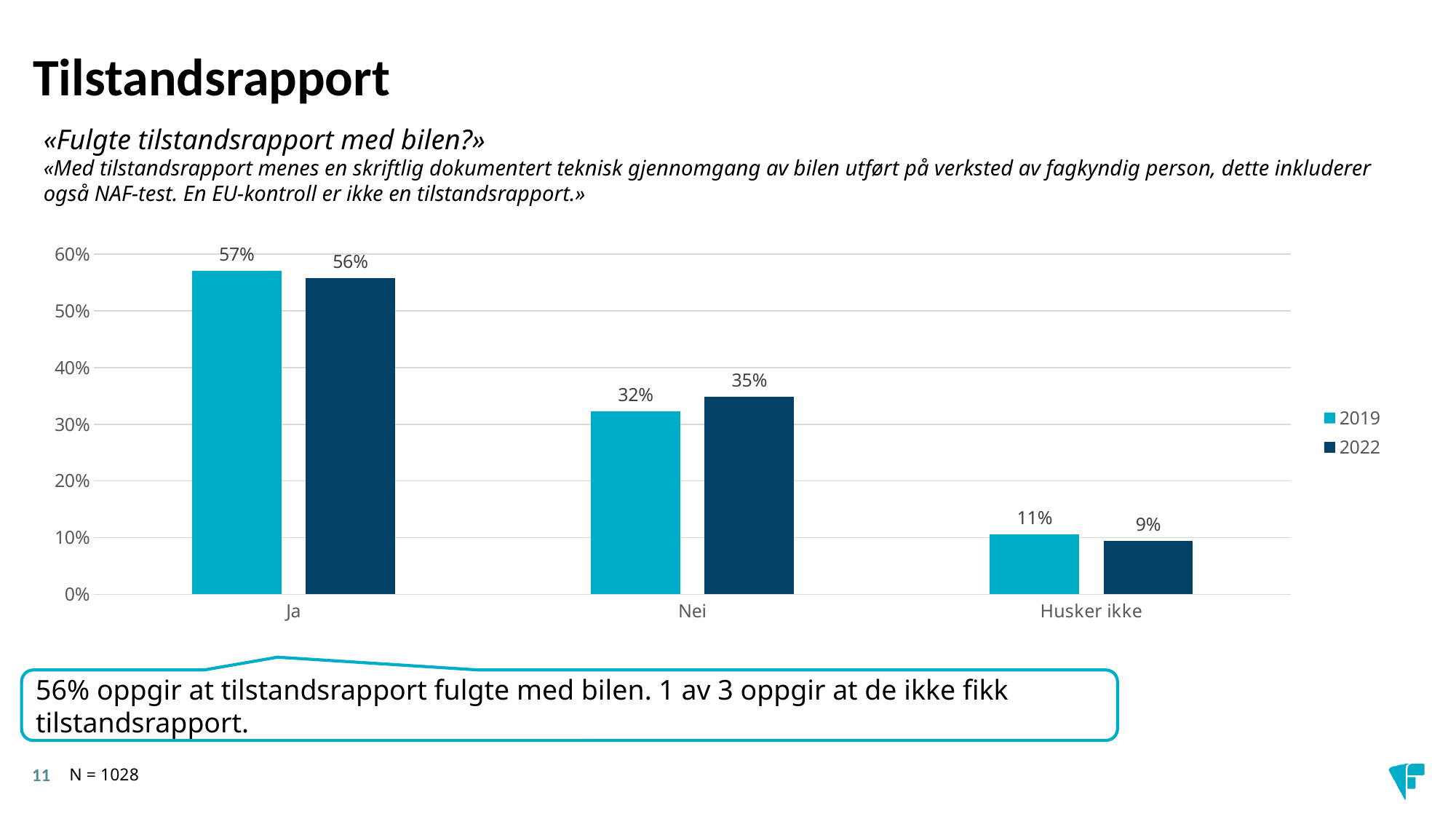
Which category has the highest value in the 2022 series? Ja Which category has the lowest value in the 2019 series? Husker ikke How many categories are shown on the x axis? 3 What is the value for "Husker ikke" in the 2022 series? 9% How many series does the legend list? 2 For "Nei", which series has the larger value, 2019 or 2022? 2022 What kind of chart is shown on the slide? Bar chart What is the value for "Nei" in the 2022 series? 35% What is the difference between the 2019 and 2022 values for "Husker ikke"? 2% What is the difference between the 2022 and 2019 values for "Nei"? 3% What is the value for "Ja" in the 2019 series? 57% Which series is shown in the darker blue colour? 2022